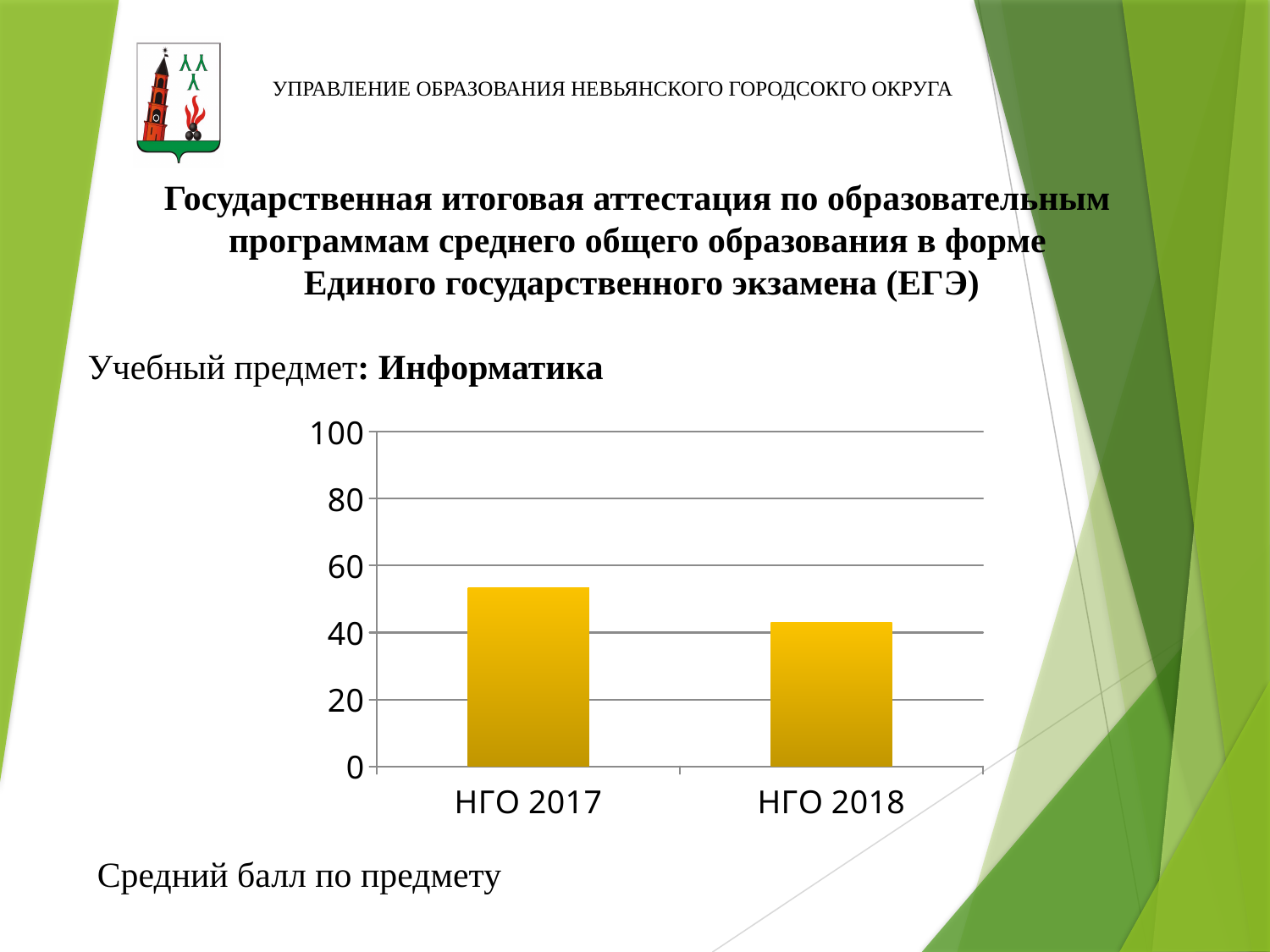
Which category has the highest value in the chart? НГО 2017 Which school subject (учебный предмет) does the chart refer to? Информатика How many bars (categories) does the chart show? 2 Which is larger, the value for НГО 2017 or the value for НГО 2018? НГО 2017 What does the caption below the chart say the chart shows? Средний балл по предмету Is the value for НГО 2018 greater or less than 60? less Is the value for НГО 2018 greater or less than 20? greater What kind of chart is shown on the slide? bar chart Do the values rise or fall from НГО 2017 to НГО 2018? fall Which category has the lowest value in the chart? НГО 2018 Is the value for НГО 2017 greater or less than 60? less